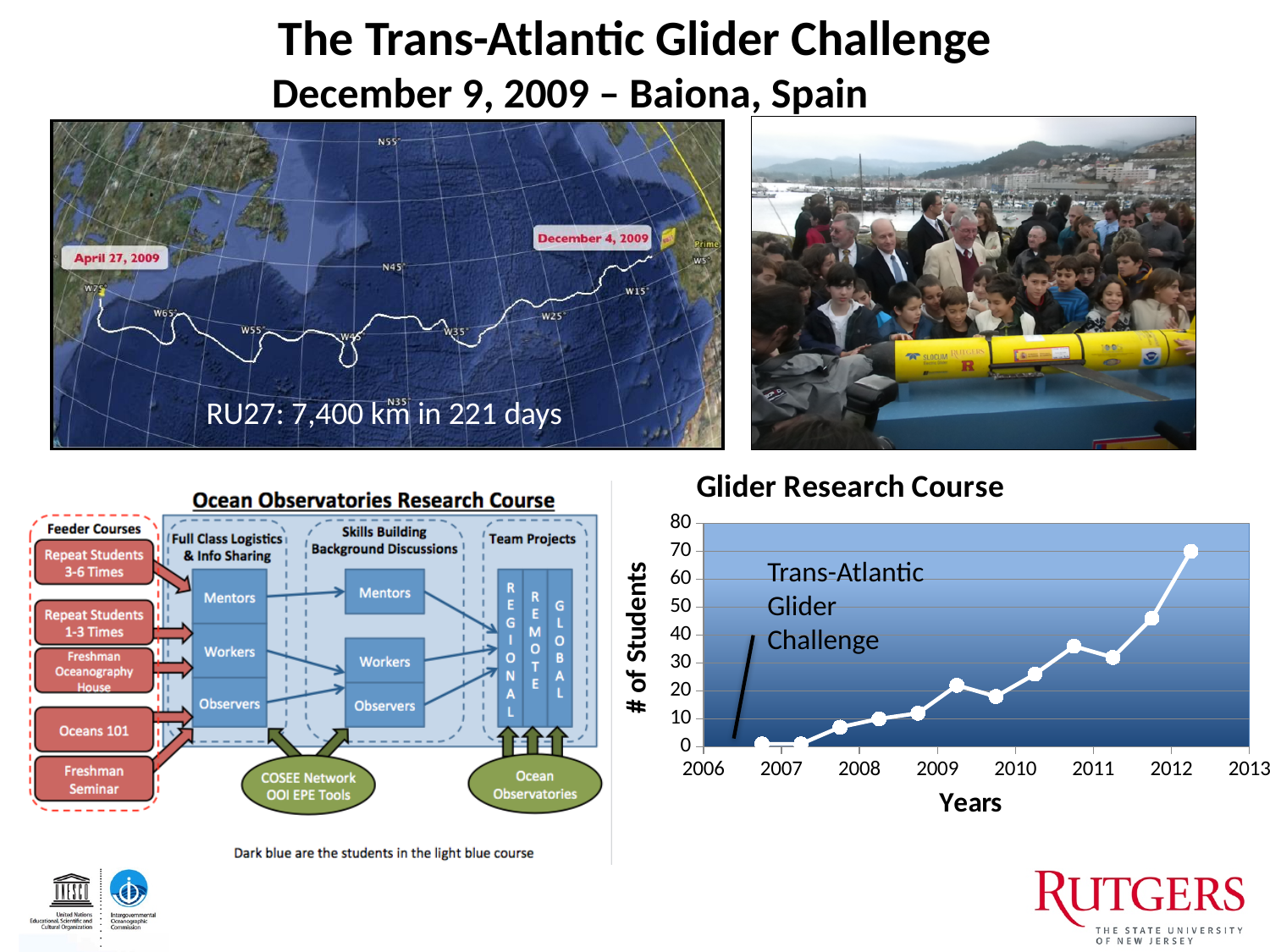
On the Glider Research Course chart, is the point plotted just before 2011 greater or less than 30? greater On the Glider Research Course chart, is the last plotted point (just after 2012) greater or less than 60? greater What is the title of the chart on the lower right of the slide? Glider Research Course On the Glider Research Course chart, is the highest plotted value greater or less than 60? greater Overall, do the values on the Glider Research Course chart rise or fall from 2006 to 2013? rise What is the highest value shown on the y axis of the Glider Research Course chart? 80 What is the label of the y axis on the Glider Research Course chart? # of Students What kind of chart is the Glider Research Course chart? line chart How many data points are plotted on the Glider Research Course chart? 12 On the Glider Research Course chart, which is larger: the point just after 2012 or the point just after 2011? the point just after 2012